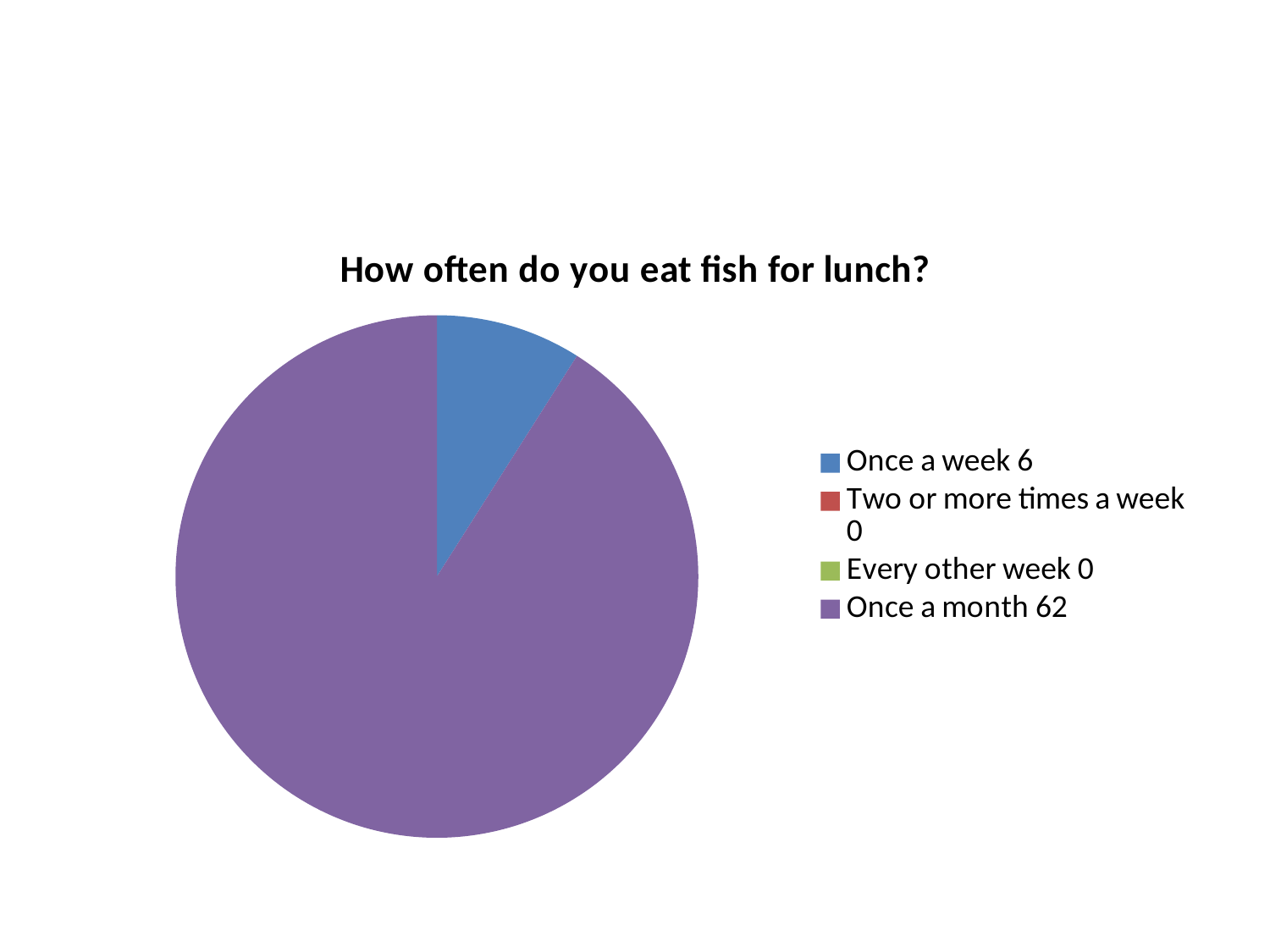
What kind of chart is shown on the slide? Pie chart What is the value for "Once a month"? 62 What is the value for "Two or more times a week"? 0 What is the total of all the values shown in the legend? 68 Which category has the highest value? Once a month What is the difference between the values for "Once a month" and "Once a week"? 56 What is the value for "Once a week"? 6 Which is larger, the value for "Once a week" or the value for "Once a month"? Once a month What is the title of the chart? How often do you eat fish for lunch? What colour is the "Once a month" slice? Purple What is the value for "Every other week"? 0 How many categories does the legend list? 4